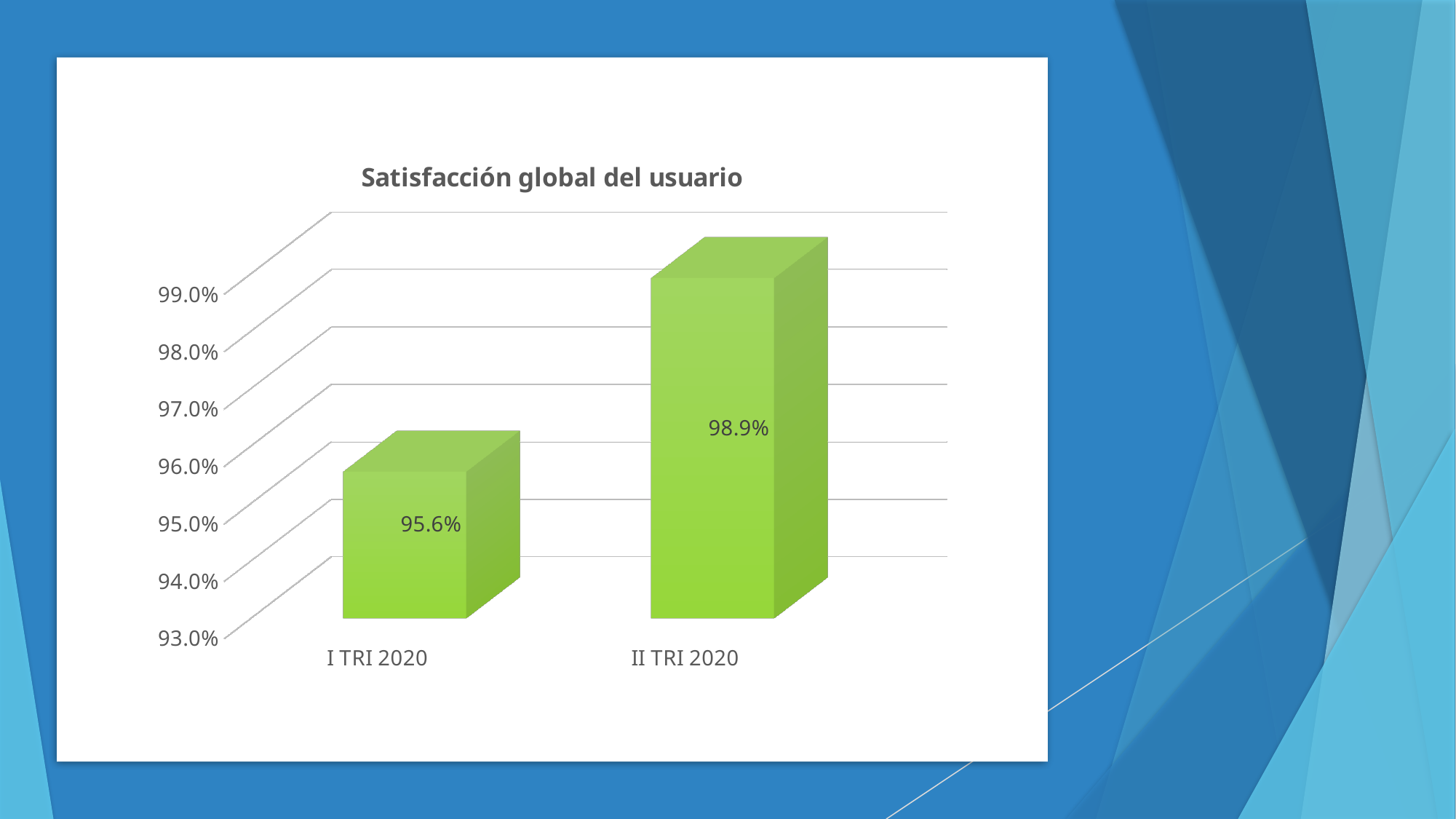
Is the value for I TRI 2020 greater or less than 96.0%? less Is the value for II TRI 2020 greater or less than 98.0%? greater What is the value for I TRI 2020? 95.6% What is the title of the chart? Satisfacción global del usuario Which is larger, the value for I TRI 2020 or II TRI 2020? II TRI 2020 Which category has the highest value? II TRI 2020 What is the value for II TRI 2020? 98.9% Which category has the lowest value? I TRI 2020 Do the values rise or fall from I TRI 2020 to II TRI 2020? rise How many categories are shown on the x axis? 2 What kind of chart is shown? bar chart What is the difference between the values for II TRI 2020 and I TRI 2020? 3.3%